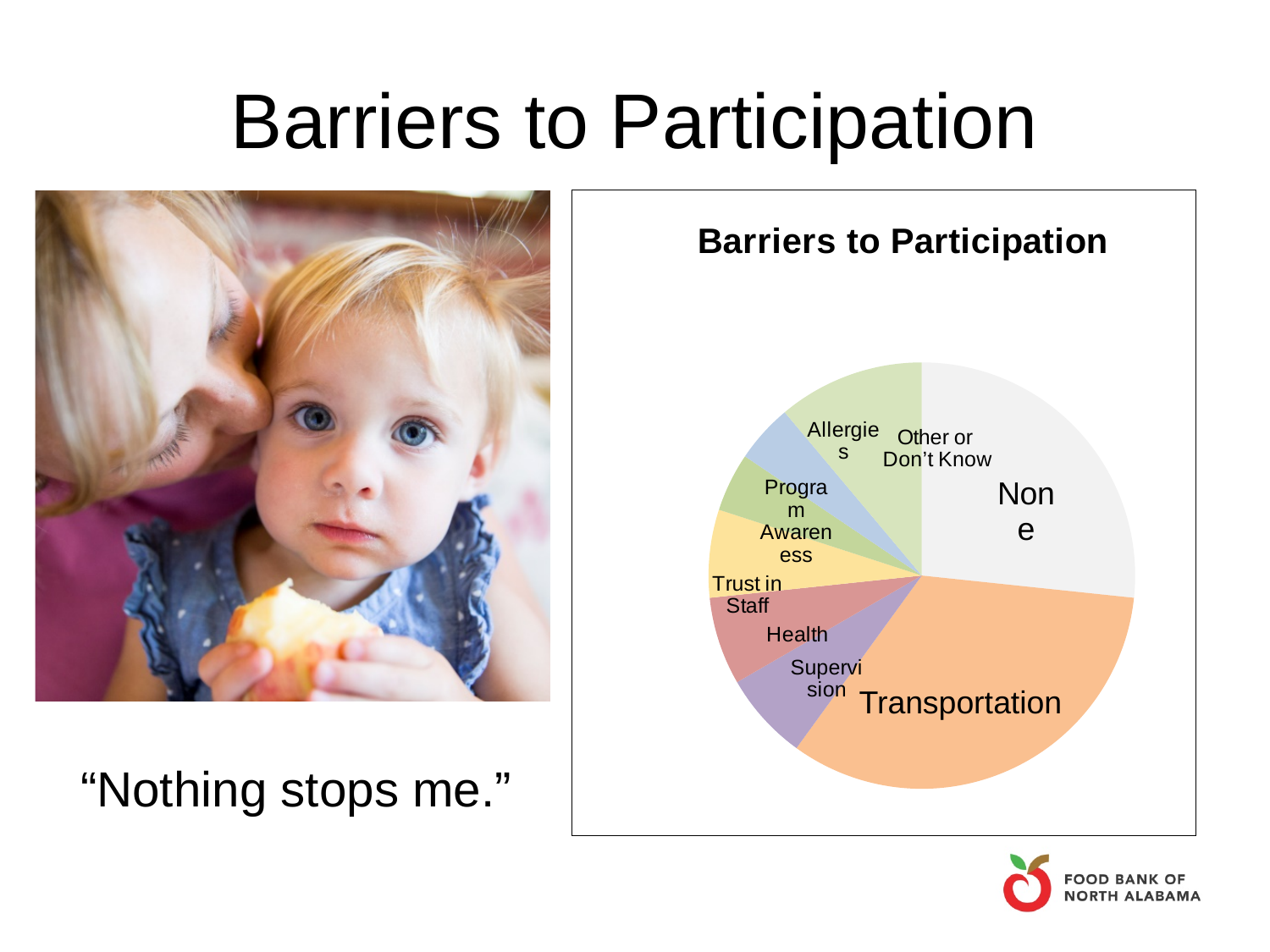
Which slice is larger, Health or Allergies? Health Which slice is larger, None or Health? None Which slice is larger, Transportation or Supervision? Transportation Which barrier has the largest slice of the pie chart? Transportation What is the title of the chart? Barriers to Participation What kind of chart is shown on the slide? Pie chart Does the pie chart include a slice labelled Trust in Staff? Yes How many slices does the pie chart have? 8